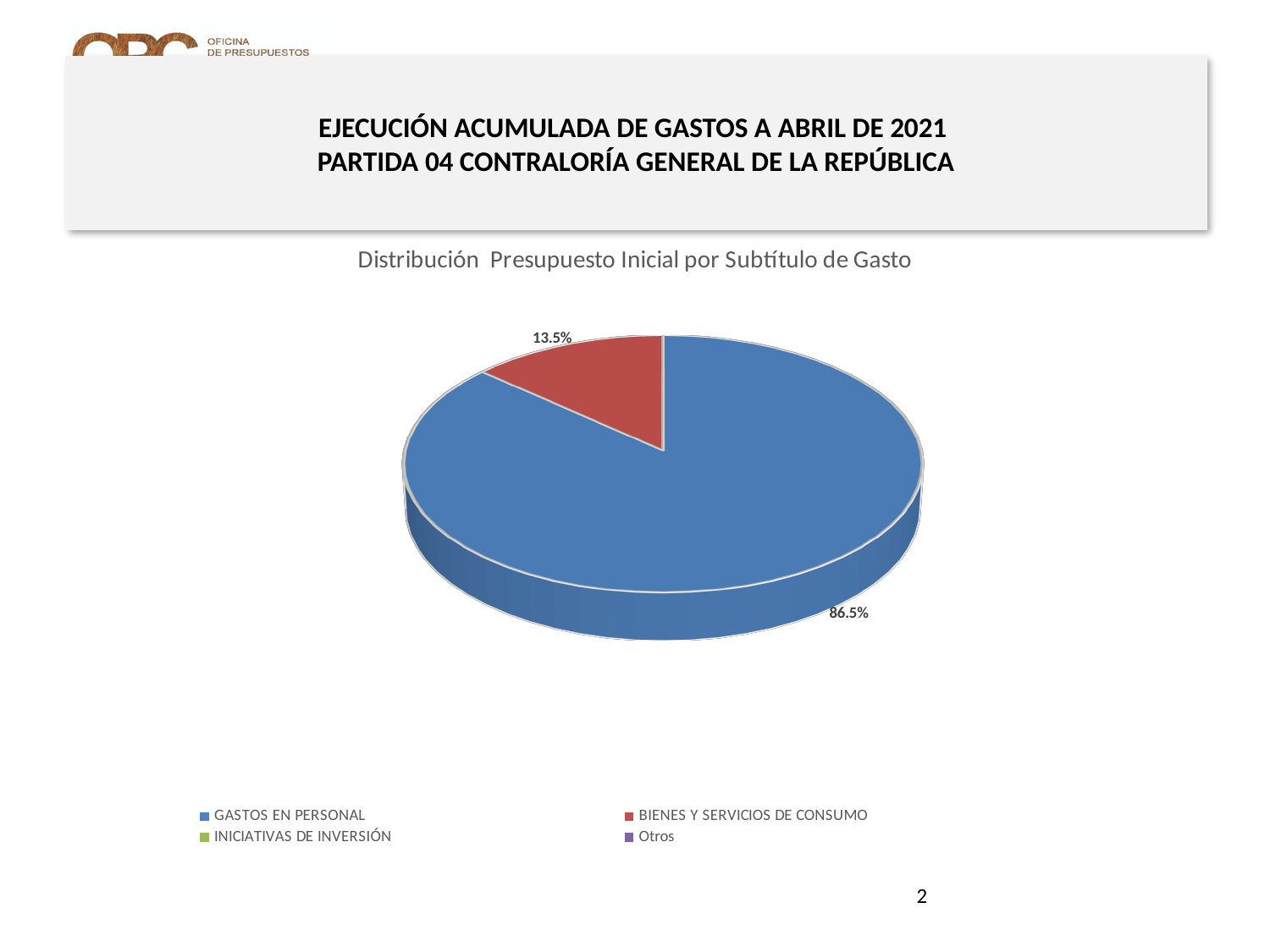
What share of the pie does GASTOS EN PERSONAL represent? 86.5% How many entries does the legend list? 4 Which of the two labelled slices is the smallest? BIENES Y SERVICIOS DE CONSUMO Which category has the largest slice of the pie? GASTOS EN PERSONAL How many slices with data labels are visible in the pie? 2 Which is larger, the slice for GASTOS EN PERSONAL or the slice for BIENES Y SERVICIOS DE CONSUMO? GASTOS EN PERSONAL What is the chart's title? Distribución Presupuesto Inicial por Subtítulo de Gasto What colour is the slice for BIENES Y SERVICIOS DE CONSUMO? red What is the difference in percentage points between the GASTOS EN PERSONAL slice and the BIENES Y SERVICIOS DE CONSUMO slice? 73.0% What kind of chart is shown on the slide? pie chart Is the share for GASTOS EN PERSONAL greater or less than 50%? greater What share of the pie does BIENES Y SERVICIOS DE CONSUMO represent? 13.5%